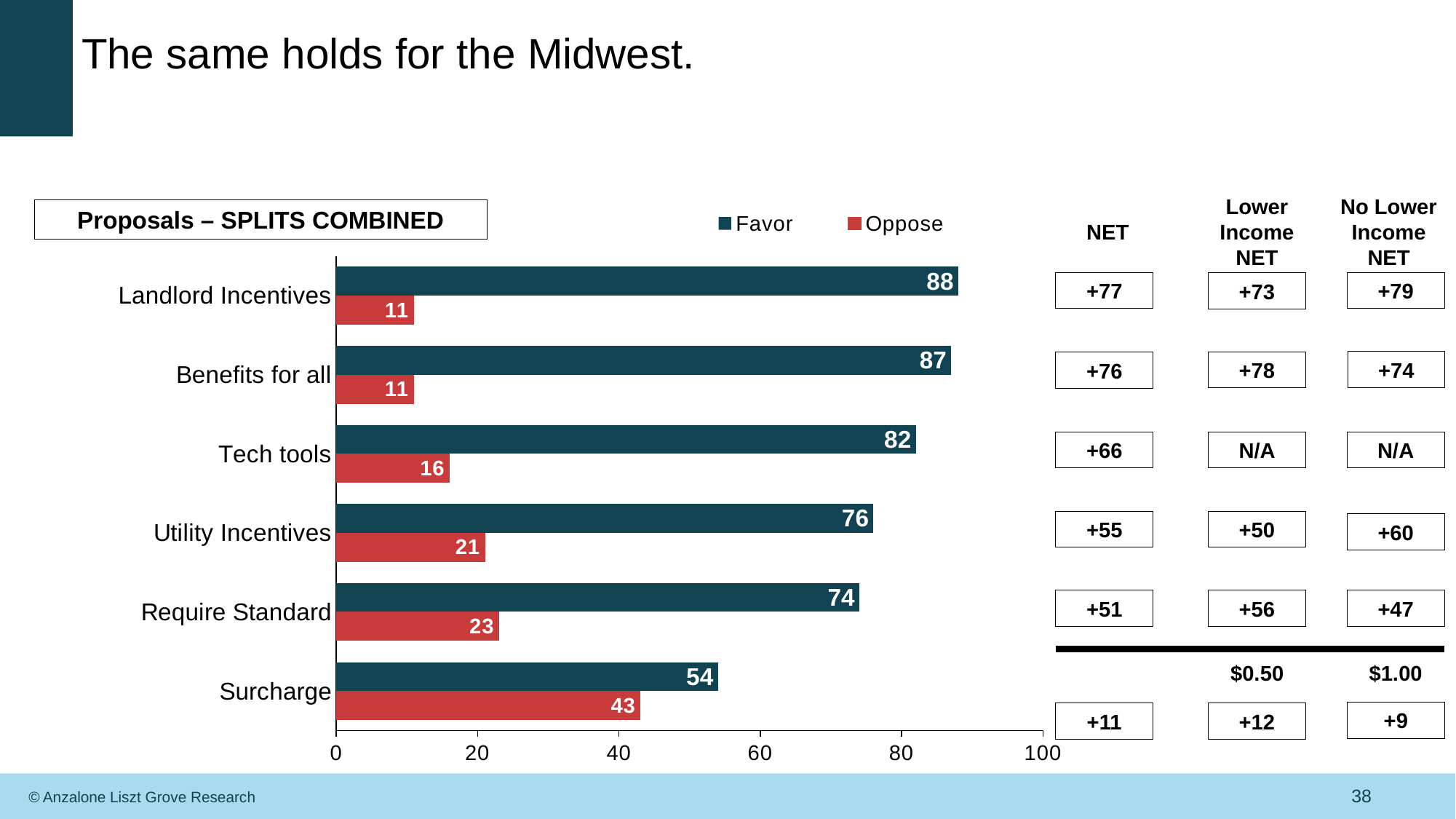
Which proposal has the lowest Favor value? Surcharge Which is larger, the Favor value for Require Standard or the Favor value for Utility Incentives? Utility Incentives What is the Oppose value for Surcharge? 43 What is the Oppose value for Tech tools? 16 Which proposal has the highest Favor value? Landlord Incentives What kind of chart is shown on the slide? Bar chart What is the Favor value for Landlord Incentives? 88 What is the title shown in the box above the chart? Proposals – SPLITS COMBINED How many proposals are shown on the chart? 6 Which proposal has the highest Oppose value? Surcharge How many series does the legend list? 2 What is the difference between the Favor and Oppose values for Utility Incentives? 55